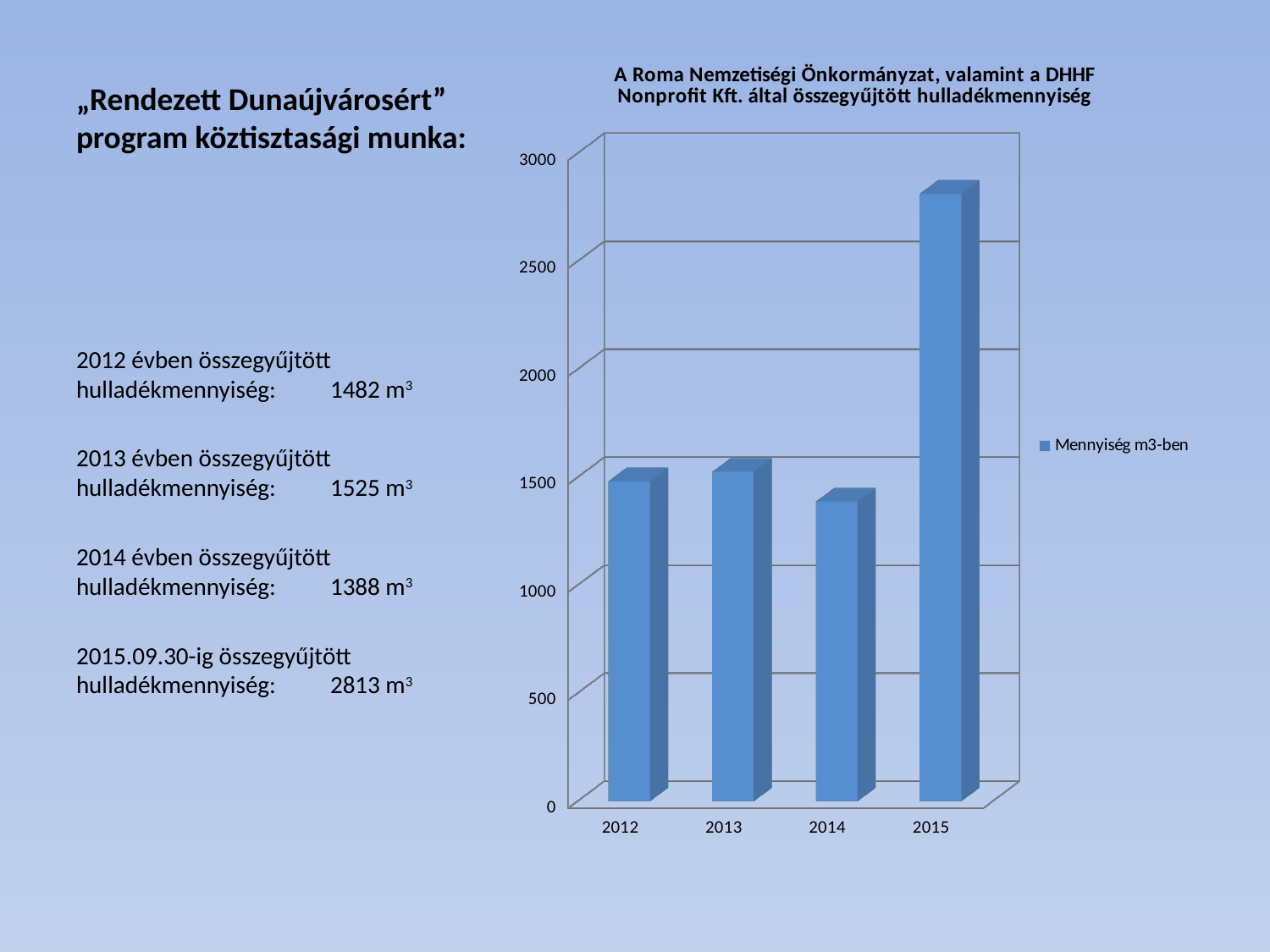
What is the legend entry of the chart? Mennyiség m3-ben Is the value for 2015 greater or less than 2500? greater What type of chart is shown on the slide? bar chart Is the value for 2014 greater or less than 1500? less According to the slide, what was the amount of waste collected in 2012? 1482 m³ How many series does the chart legend list? 1 How many years are shown on the x axis of the chart? 4 Does the value rise or fall from 2014 to 2015? rise Which year has the lowest bar in the chart? 2014 Which year has the highest bar in the chart? 2015 Is the value for 2013 greater or less than 1000? greater Which is larger, the value for 2015 or the value for 2013? 2015